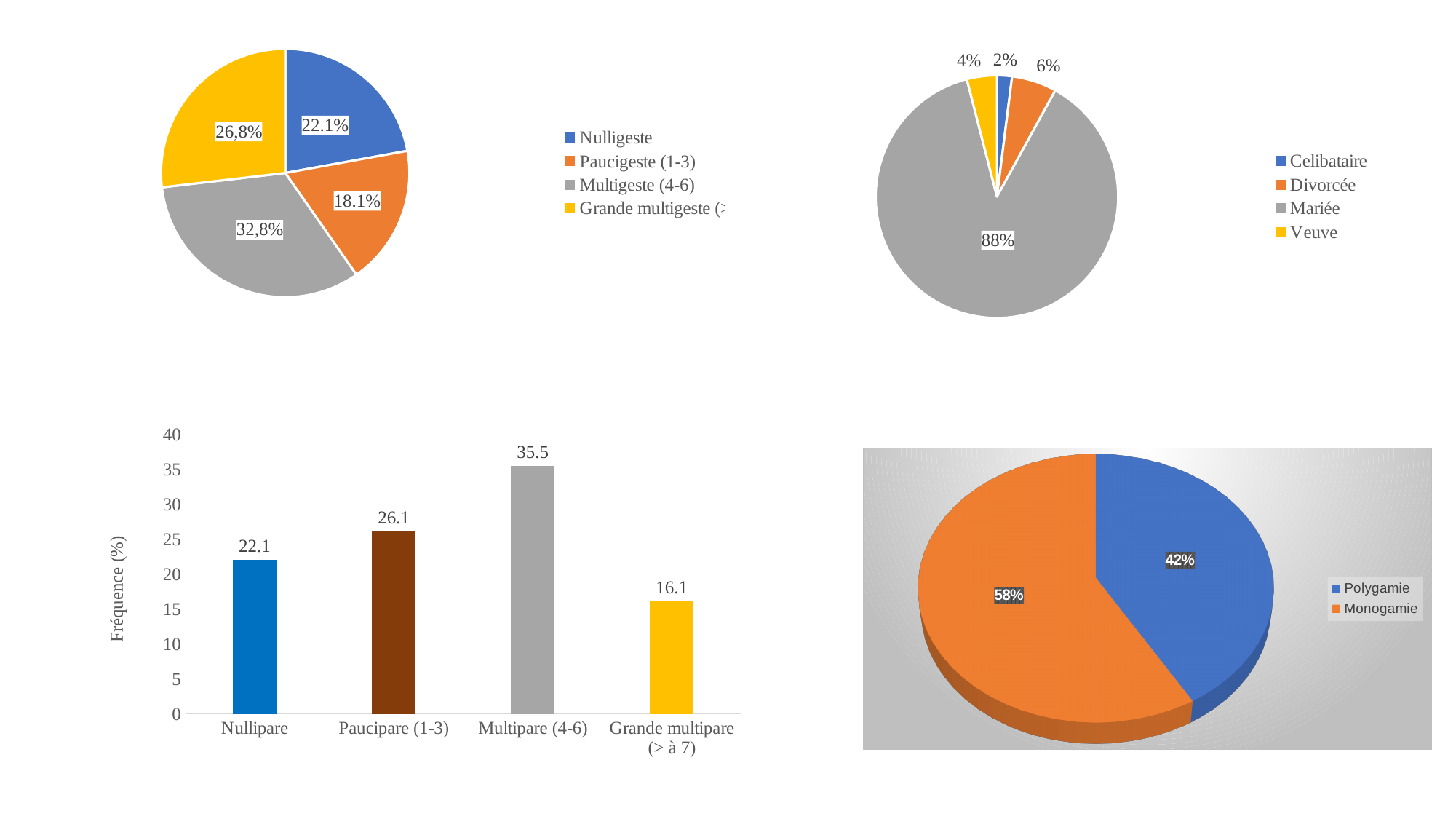
In the top-right pie chart, what is the value for Mariée? 88% In the top-right pie chart, what is the value for Divorcée? 6% In the bottom-left chart, what is the difference between the values for Paucipare (1-3) and Grande multipare (> à 7)? 10 In the top-left pie chart, what is the value for Nulligeste? 22.1% In the top-left pie chart, what is the value for Multigeste (4-6)? 32,8% In the bottom-left chart, what is the value for Multipare (4-6)? 35.5 In the top-right pie chart, which category has the smallest slice? Celibataire What kind of chart is the bottom-left chart? Bar chart In the top-right pie chart, how many categories does the legend list? 4 In the top-left pie chart, which category has the largest slice? Multigeste (4-6) In the bottom-right pie chart, what is the value for Monogamie? 58% In the top-left pie chart, which category has the smallest slice? Paucigeste (1-3)